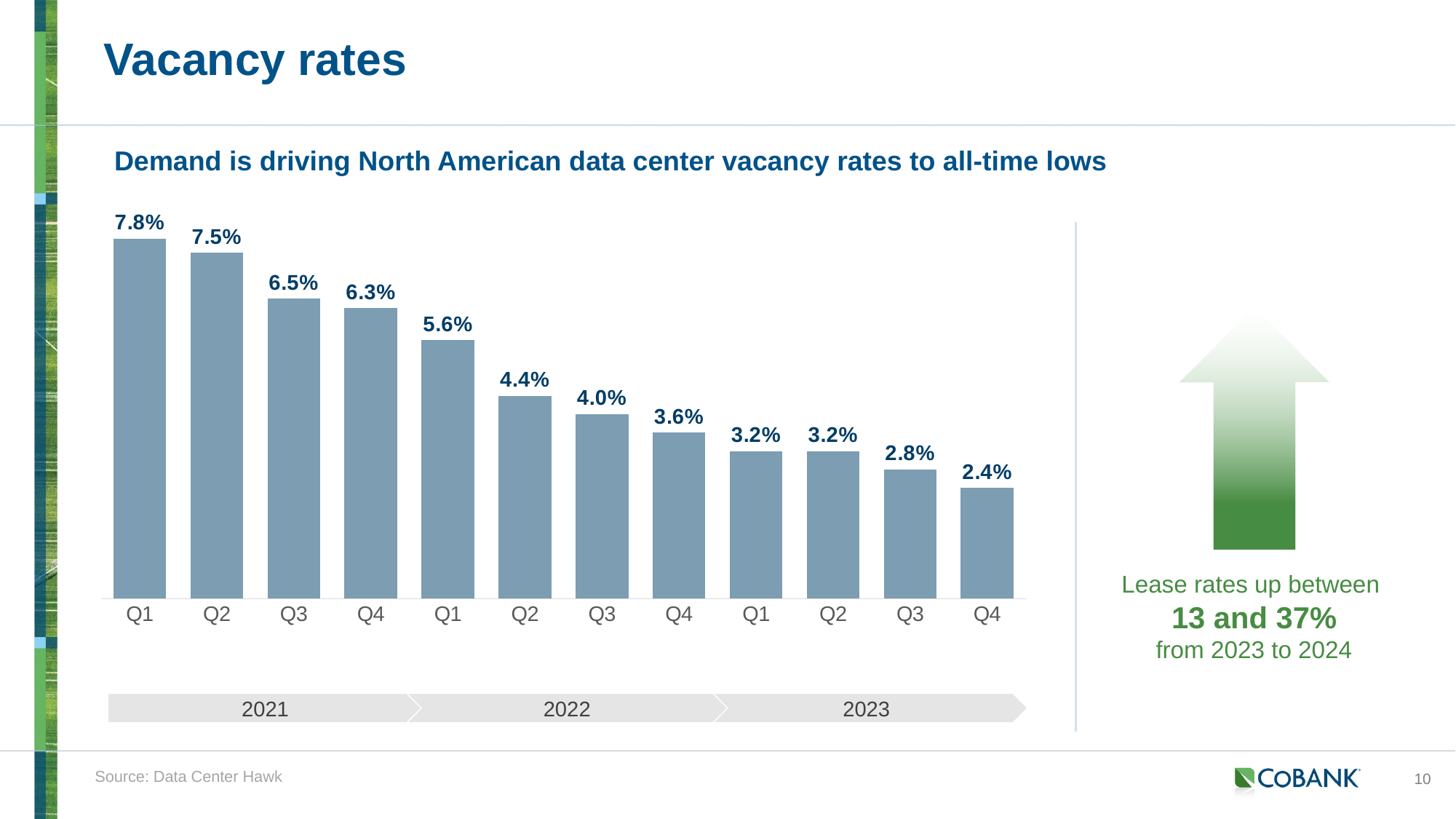
Which quarter has the lowest vacancy rate? Q4 2023 Which quarter has the highest vacancy rate? Q1 2021 What is the vacancy rate for Q4 2023? 2.4% What is the difference between the vacancy rate in Q4 2021 and Q1 2022? 0.7% Which is larger, the vacancy rate in Q3 2022 or Q1 2023? Q3 2022 Do vacancy rates rise or fall from Q1 2021 to Q4 2023? Fall What is the vacancy rate for Q2 2022? 4.4% What is the vacancy rate for Q1 2021? 7.8% What is the vacancy rate for Q3 2023? 2.8% How many quarterly bars are shown in the chart? 12 What kind of chart is shown on the slide? Bar chart What is the difference between the vacancy rate in Q1 2021 and Q4 2023? 5.4%